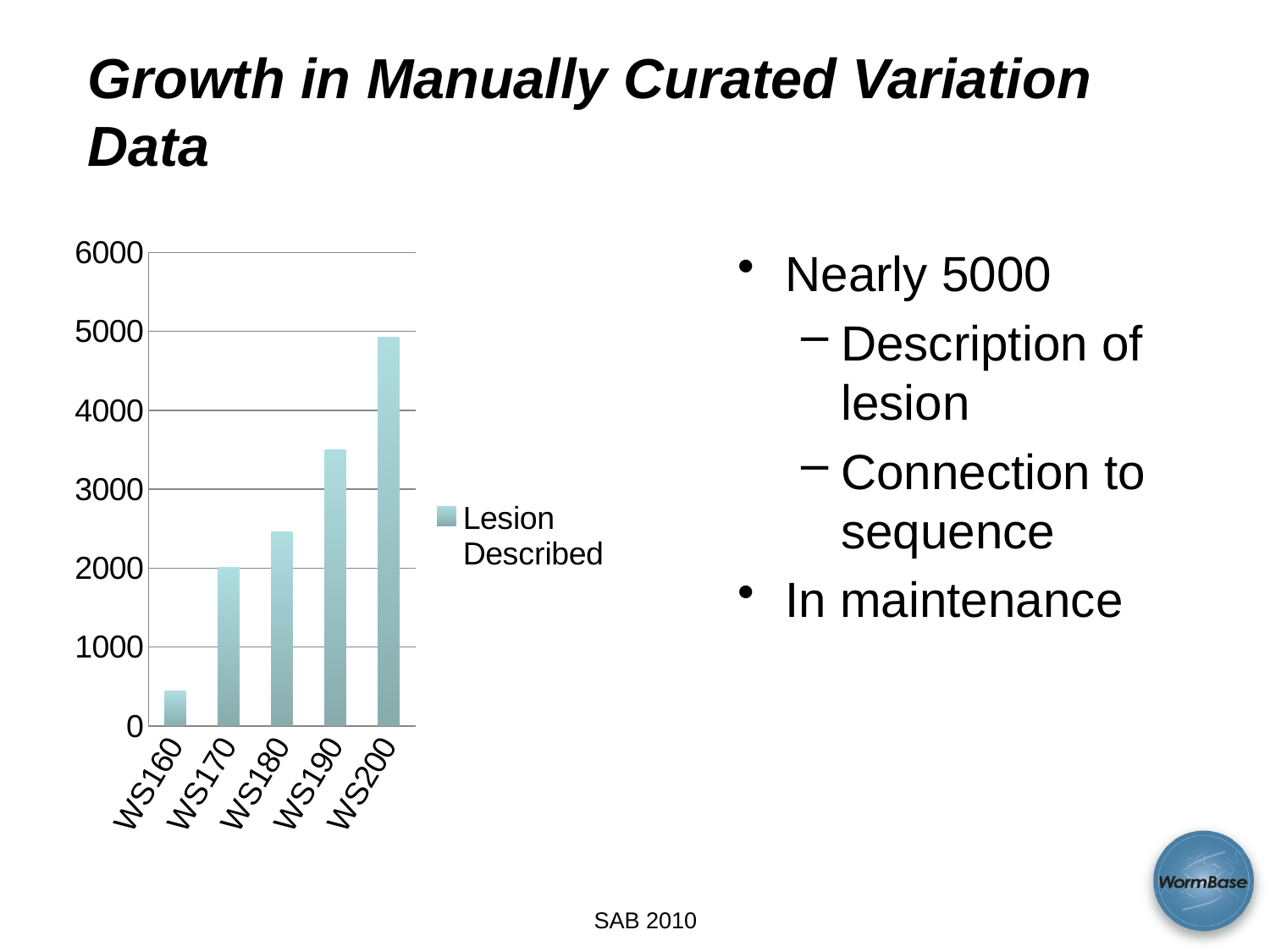
What is the name of the series shown in the chart legend? Lesion Described Is the value for WS190 greater or less than 3000? greater Which category has the highest value in the chart? WS200 How many series does the chart legend list? 1 What kind of chart is shown on the slide? bar chart Is the value for WS200 greater or less than 4000? greater How many categories are shown on the x axis of the chart? 5 Is the value for WS160 greater or less than 1000? less Which category has the lowest value in the chart? WS160 Which has a larger value, WS160 or WS170? WS170 Do the values rise or fall from WS160 to WS200? rise Which has a larger value, WS180 or WS190? WS190